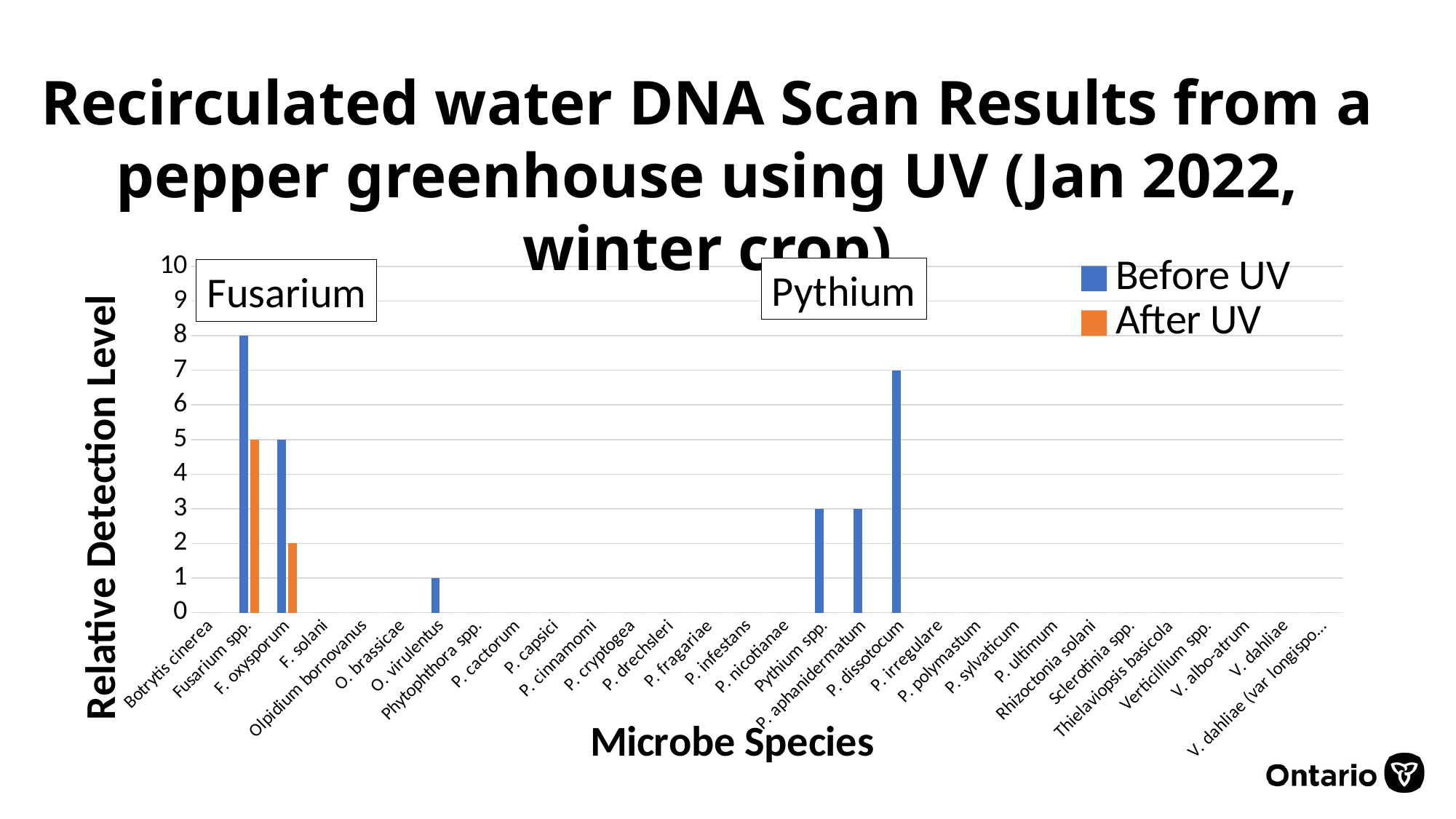
What is the Before UV relative detection level for Fusarium spp.? 8 Is the Before UV value for O. virulentus greater or less than 2? less What is the After UV relative detection level for F. oxysporum? 2 Which is larger, the Before UV level for P. dissotocum or the Before UV level for Pythium spp.? P. dissotocum What is the difference between the Before UV and After UV detection levels for Fusarium spp.? 3 What is the Before UV relative detection level for F. oxysporum? 5 How many series does the legend list? 2 What type of chart is shown on the slide? bar chart What is the Before UV relative detection level for P. dissotocum? 7 Which colour represents the After UV series in the legend? orange What is the After UV relative detection level for Fusarium spp.? 5 Which microbe species has the highest Before UV relative detection level? Fusarium spp.